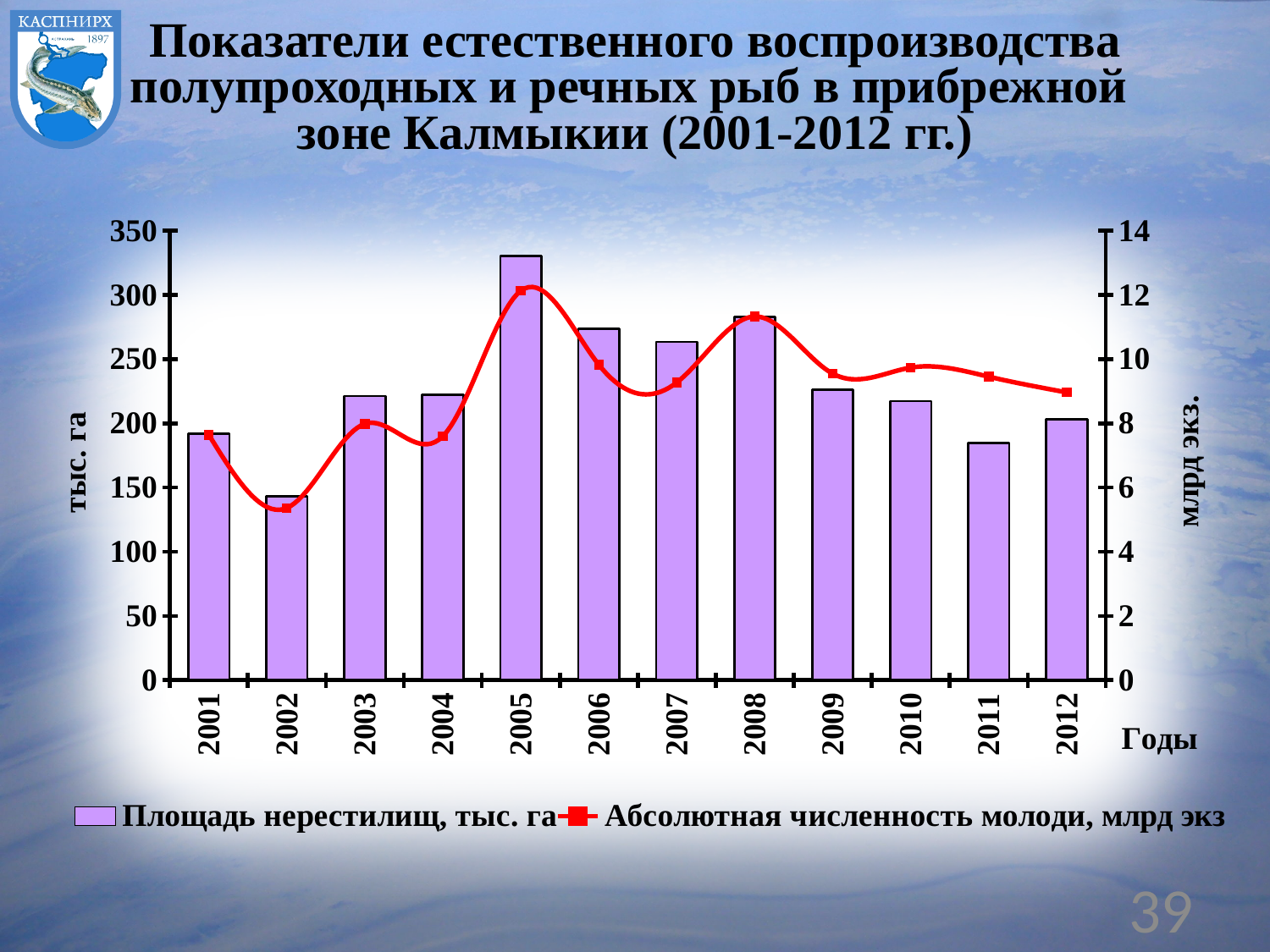
In which year does the line 'Абсолютная численность молоди, млрд экз' reach its highest point? 2005 In which year is the bar for 'Площадь нерестилищ, тыс. га' the highest? 2005 What is the label of the right-hand vertical axis of the chart? млрд экз. Is the bar value for 'Площадь нерестилищ' in 2005 greater or less than 300? greater Which year has the larger bar for 'Площадь нерестилищ': 2008 or 2011? 2008 How many years are shown along the x axis of the chart? 12 What kind of chart is shown on the slide? A combined bar and line chart How many series does the chart's legend list? 2 In which year is the bar for 'Площадь нерестилищ, тыс. га' the lowest? 2002 Is the bar value for 'Площадь нерестилищ' in 2002 greater or less than 150? less In which year does the line 'Абсолютная численность молоди, млрд экз' reach its lowest point? 2002 Is the value of 'Абсолютная численность молоди' in 2008 greater or less than 10? greater